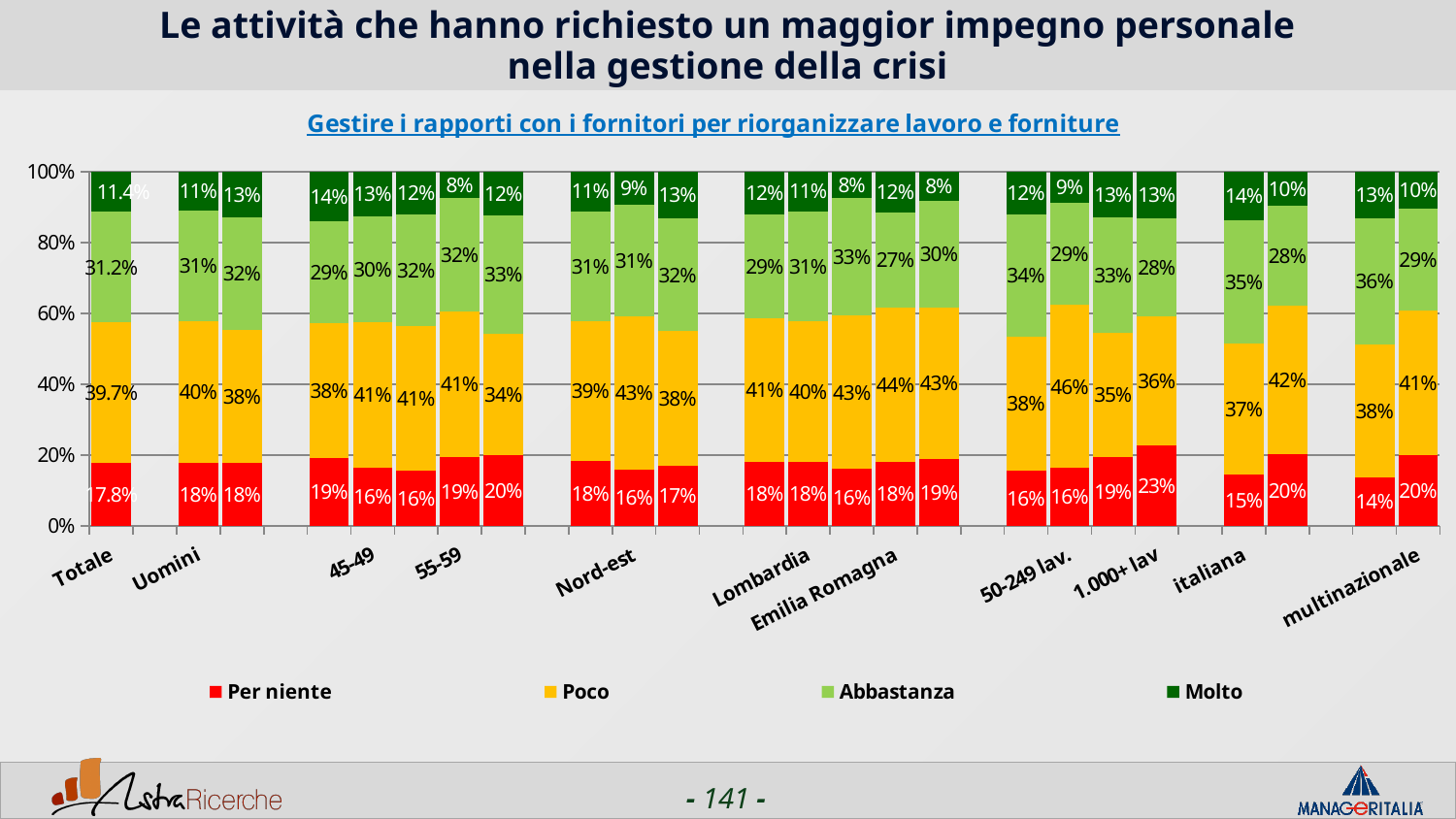
Which is larger, the 'Per niente' value for 1.000+ lav or for italiana? 1.000+ lav What is the difference between the 'Poco' value for multinazionale and the 'Poco' value for italiana? 4% What is the 'Molto' value for Totale? 11.4% What kind of chart is shown on the slide? Stacked bar chart What is the 'Abbastanza' value for italiana? 35% How many series does the legend list? 4 What is the 'Poco' value for 50-249 lav.? 46% What is the 'Molto' value for Emilia Romagna? 12% What is the 'Per niente' value for 1.000+ lav? 23% Which legend entry is shown in red? Per niente What is the 'Poco' value for Totale? 39.7% What is the 'Per niente' value for Totale? 17.8%